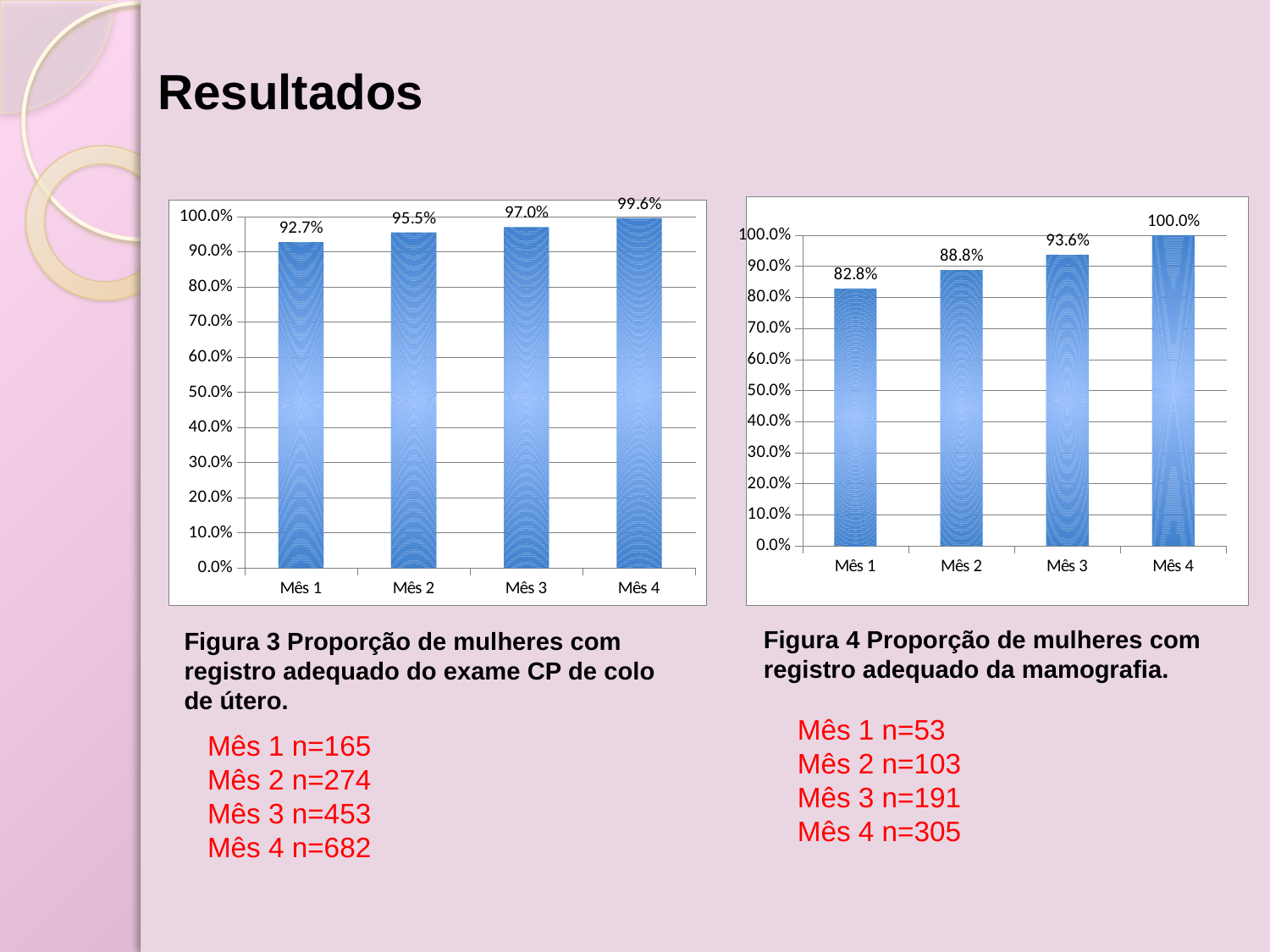
In the left chart (Figura 3, exame CP de colo de útero), what is the difference between the values for Mês 3 and Mês 1? 4.3% What kind of chart is the left chart (Figura 3, exame CP de colo de útero)? bar chart In the right chart (Figura 4, mamografia), which month has the lowest value? Mês 1 In the left chart (Figura 3, exame CP de colo de útero), what is the value for Mês 1? 92.7% In the right chart (Figura 4, mamografia), what is the difference between the values for Mês 4 and Mês 1? 17.2% In the right chart (Figura 4, mamografia), what is the value for Mês 4? 100.0% In the left chart (Figura 3, exame CP de colo de útero), which month has the highest value? Mês 4 In the left chart (Figura 3, exame CP de colo de útero), do the values rise or fall from Mês 1 to Mês 4? rise In the right chart (Figura 4, mamografia), which is larger, the value for Mês 2 or the value for Mês 3? Mês 3 In the right chart (Figura 4, mamografia), what is the value for Mês 2? 88.8% In the left chart (Figura 3, exame CP de colo de útero), what is the value for Mês 4? 99.6% How many months (categories) are shown in the right chart (Figura 4, mamografia)? 4